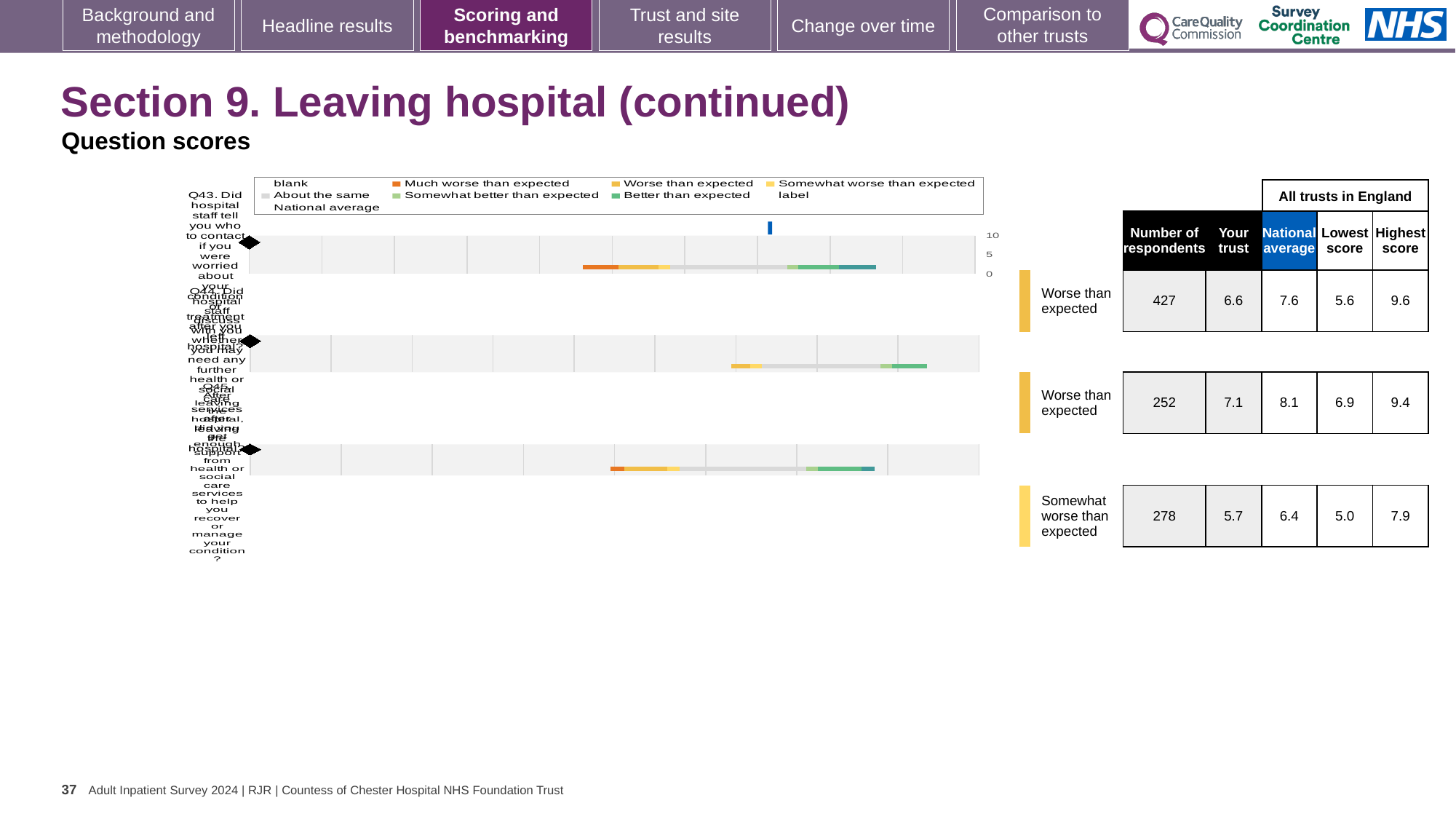
Which question row has the highest 'Your trust' score? Q44 (7.1) What is the difference between the national average and the trust score for Q43? 1.0 What is the 'Your trust' score for Q43 (Did hospital staff tell you who to contact if you were worried about your condition or treatment after you left hospital)? 6.6 Is the trust score for Q43 greater or less than 5 on the chart axis? greater What kind of chart is shown on the slide? bar chart How many respondents answered the third question row (Q45)? 278 How many question rows (bars) does the chart show? 3 What is the national average score for the second question row (Q44)? 8.1 What is the highest score among all trusts in England for Q43? 9.6 Which question row has the lowest 'Your trust' score? Q45 (5.7) For Q45, which is larger: the trust score or the national average? national average What benchmark category is shown for the third question row (Q45)? Somewhat worse than expected